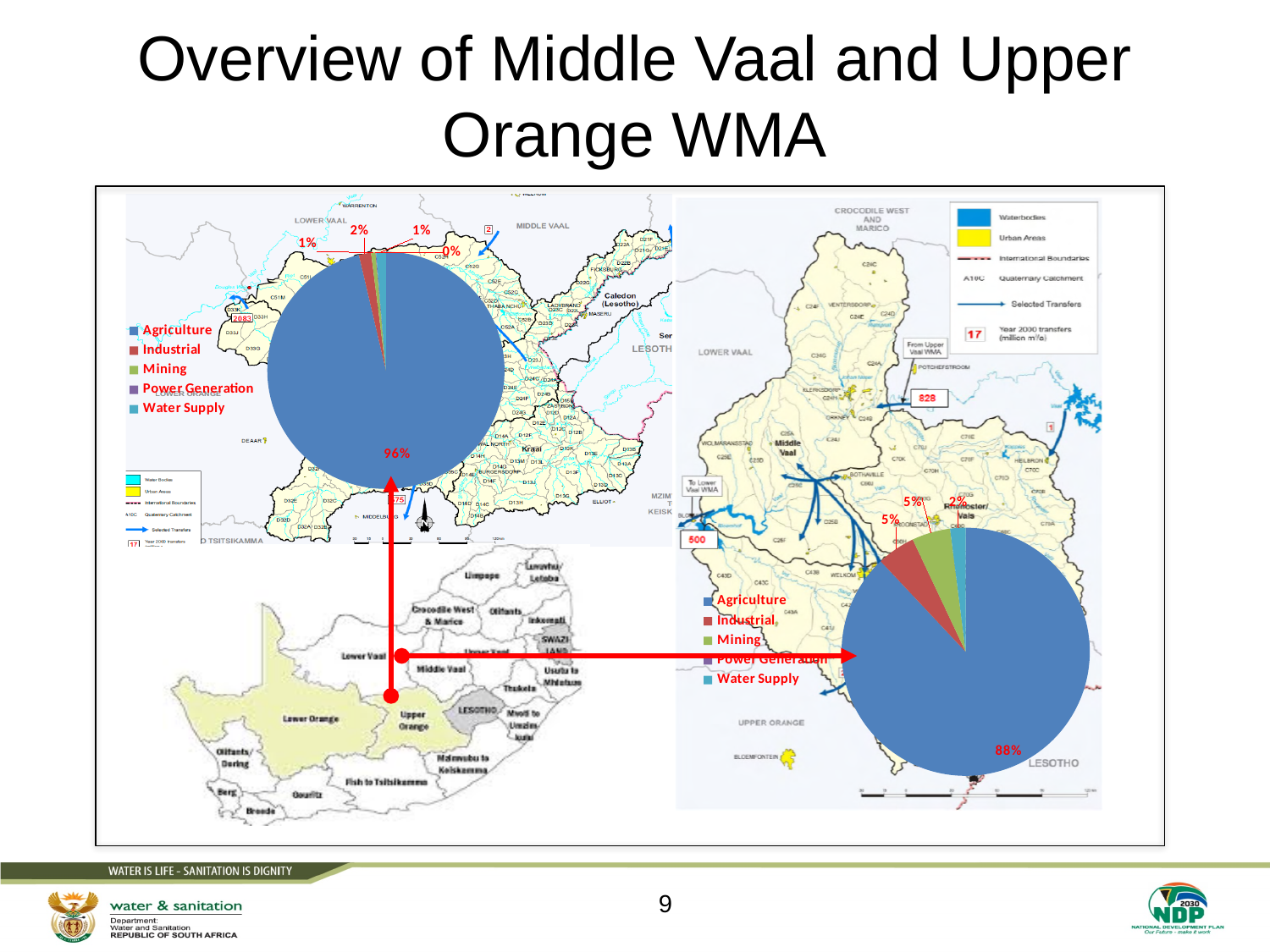
What type of chart is used on the right side of the slide to show water use shares? Pie chart On the left pie chart, which category has the largest share? Agriculture What is the difference in percentage points between the Agriculture share on the left pie chart and on the right pie chart? 8 percentage points How many categories does the legend of the right pie chart list? 5 Which category is listed last in the legend of the left pie chart? Water Supply On the right pie chart, which category has the largest share? Agriculture On the right pie chart, what share is labelled for the largest slice? 88% What type of chart is used on the left side of the slide to show water use shares? Pie chart How many categories does the legend of the left pie chart list? 5 On the left pie chart, what share is labelled for the largest slice? 96% Which pie chart shows a larger share for Agriculture, the left one or the right one? The left one Which category is shown in blue in the legends of both pie charts? Agriculture